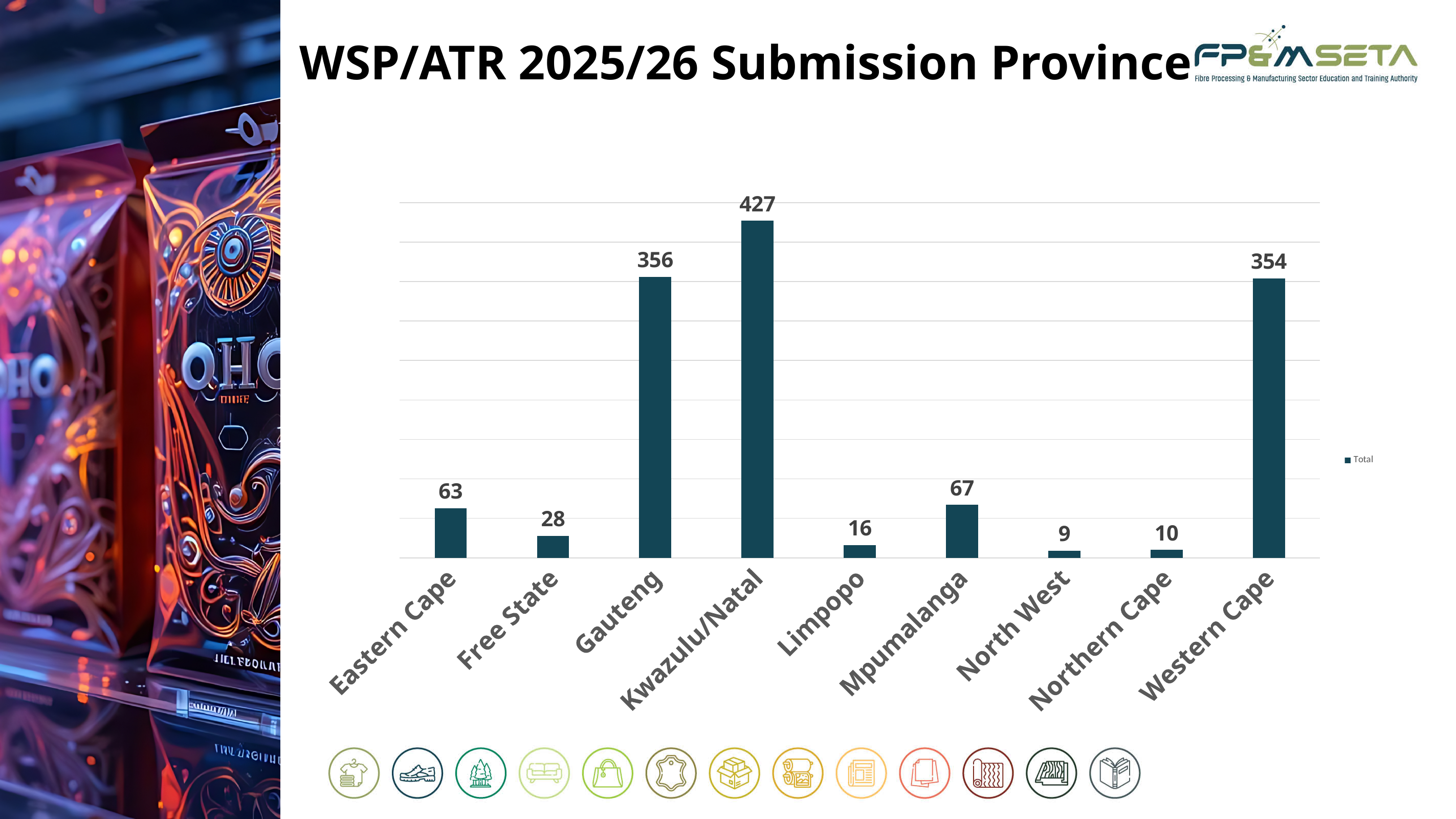
What is the value for Northern Cape? 10 What is the name of the series shown in the legend? Total What kind of chart is shown on the slide? Bar chart What is the difference between the values for Mpumalanga and Eastern Cape? 4 Which province has the lowest value? North West What is the value for Gauteng? 356 How many provinces are shown on the chart? 9 Which is larger, the value for Free State or the value for Limpopo? Free State How many series does the legend list? 1 What is the value for Kwazulu/Natal? 427 Which province has the highest value? Kwazulu/Natal What is the difference between the values for Kwazulu/Natal and Western Cape? 73